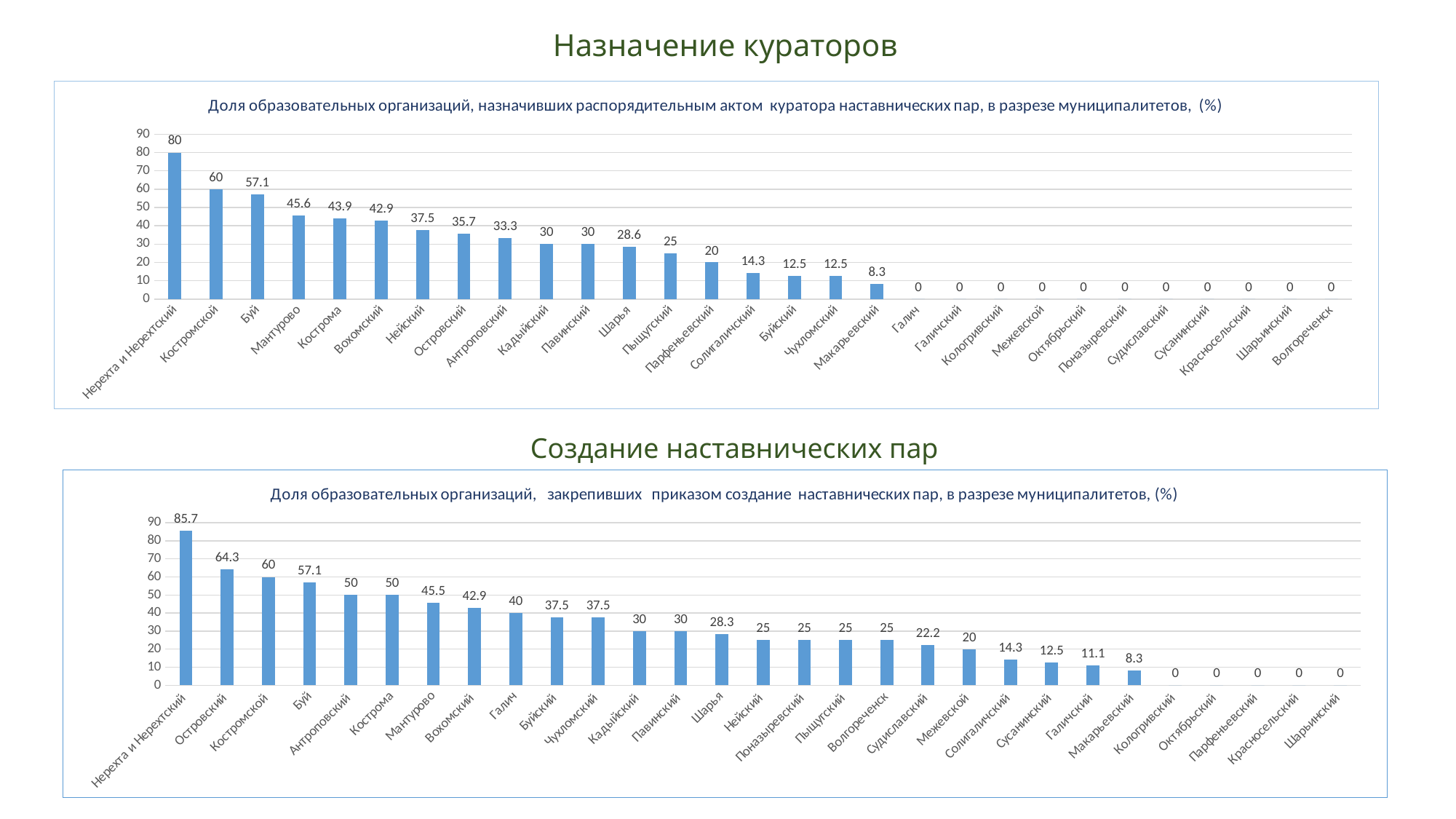
In the top chart (Назначение кураторов), what kind of chart is shown? Bar chart In the bottom chart (Создание наставнических пар), what is the value for Нерехта и Нерехтский? 85.7 In the top chart (Назначение кураторов), what is the value for Мантурово? 45.6 In the bottom chart (Создание наставнических пар), what is the difference between the values for Судиславский and Межевской? 2.2 In the bottom chart (Создание наставнических пар), what is the value for Галичский? 11.1 In the bottom chart (Создание наставнических пар), how many municipalities are shown on the x axis? 29 In the top chart (Назначение кураторов), which municipality has the highest value? Нерехта и Нерехтский In the bottom chart (Создание наставнических пар), what is the value for Островский? 64.3 In the top chart (Назначение кураторов), what is the value for Макарьевский? 8.3 In the top chart (Назначение кураторов), what is the difference between the values for Костромской and Буй? 2.9 In the top chart (Назначение кураторов), which is larger: the value for Нейский or the value for Островский? Нейский In the bottom chart (Создание наставнических пар), do the values rise or fall from left to right along the x axis? Fall